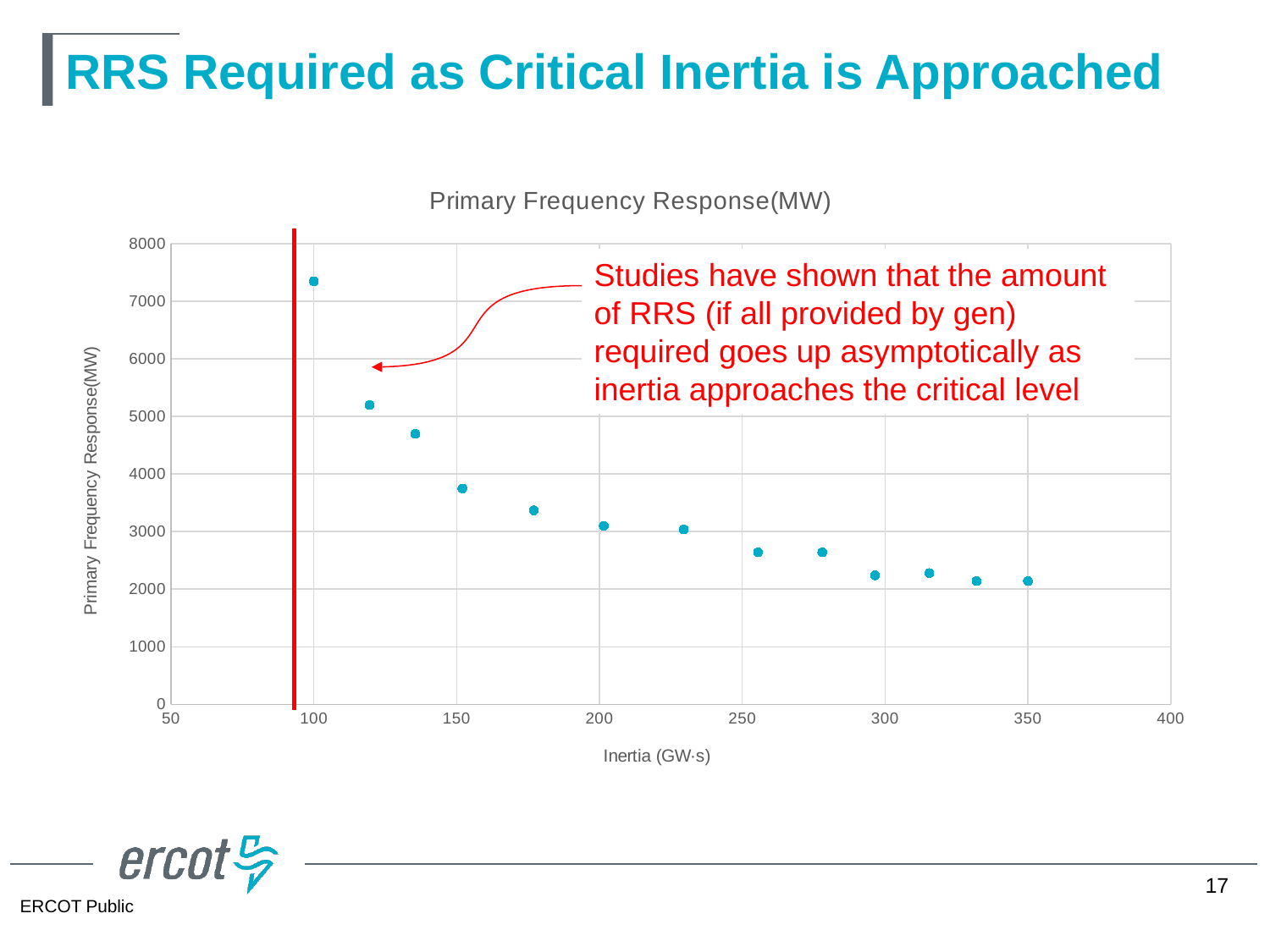
Which has the larger Primary Frequency Response value, the point at inertia 100 or the point at inertia 350? the point at inertia 100 Is the Primary Frequency Response value for the point at inertia 350 greater or less than 3000? less Is the Primary Frequency Response value for the point at inertia 150 greater or less than 4000? less What kind of chart is shown on the slide? scatter plot As inertia increases along the x axis, do the plotted Primary Frequency Response values rise or fall? fall What is the title of the chart? Primary Frequency Response(MW) What is the label of the x axis? Inertia (GW·s) Is the Primary Frequency Response value for the point at inertia 200 greater or less than 4000? less How many data points are plotted on the chart? 13 Which point has the highest Primary Frequency Response value? the point at inertia 100